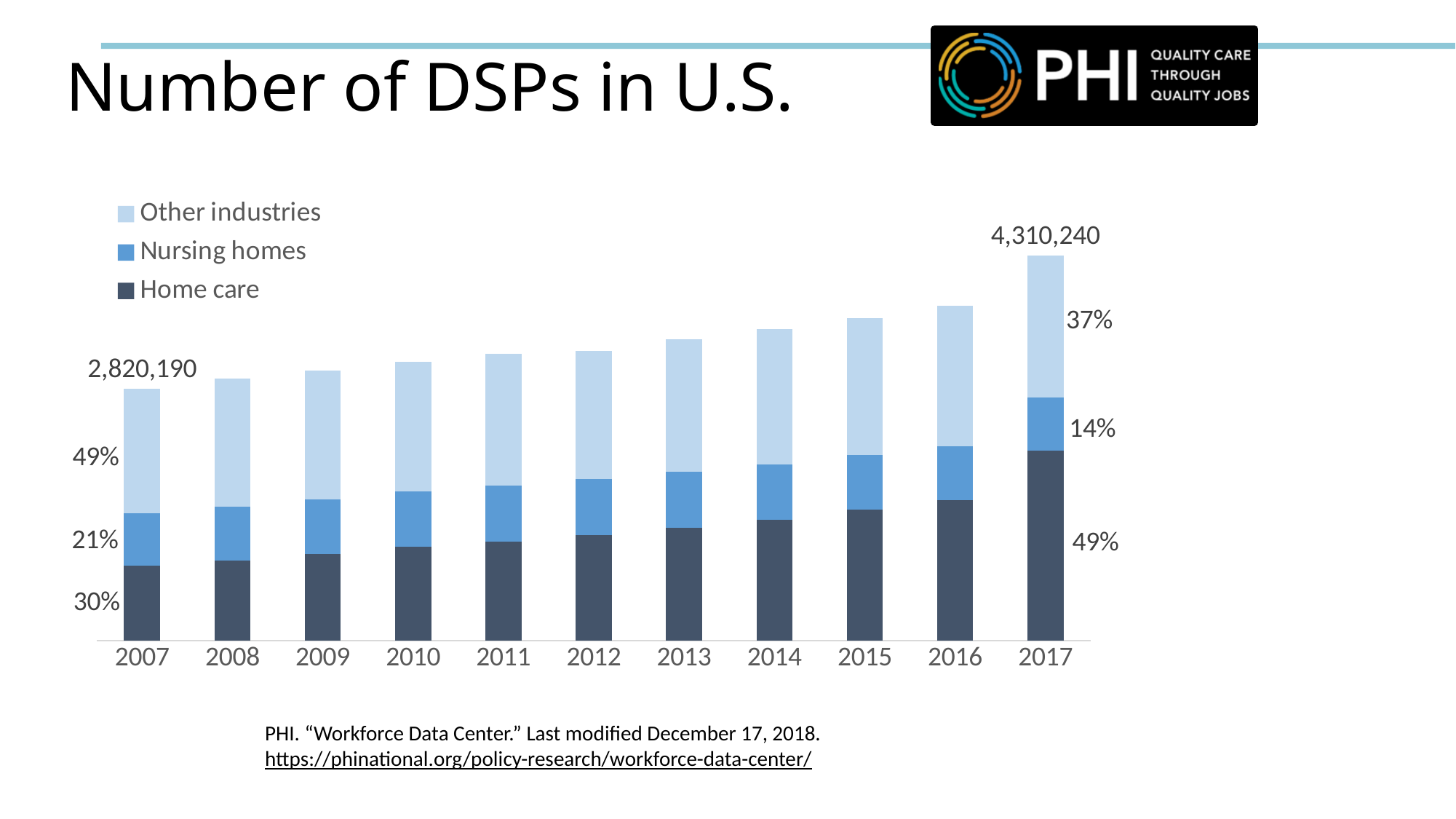
What percentage of DSPs worked in other industries in 2017? 37% Which year has the lowest total number of DSPs? 2007 How many years are shown on the x axis? 11 By how much did the total number of DSPs increase from 2007 to 2017? 1,490,050 What percentage of DSPs worked in nursing homes in 2007? 21% How many series does the legend list? 3 What percentage of DSPs worked in home care in 2017? 49% What percentage of DSPs worked in home care in 2007? 30% Which year has the highest total number of DSPs? 2017 What is the total number of DSPs shown for 2017? 4,310,240 What is the total number of DSPs shown for 2007? 2,820,190 Does the total number of DSPs rise or fall from 2007 to 2017? Rise